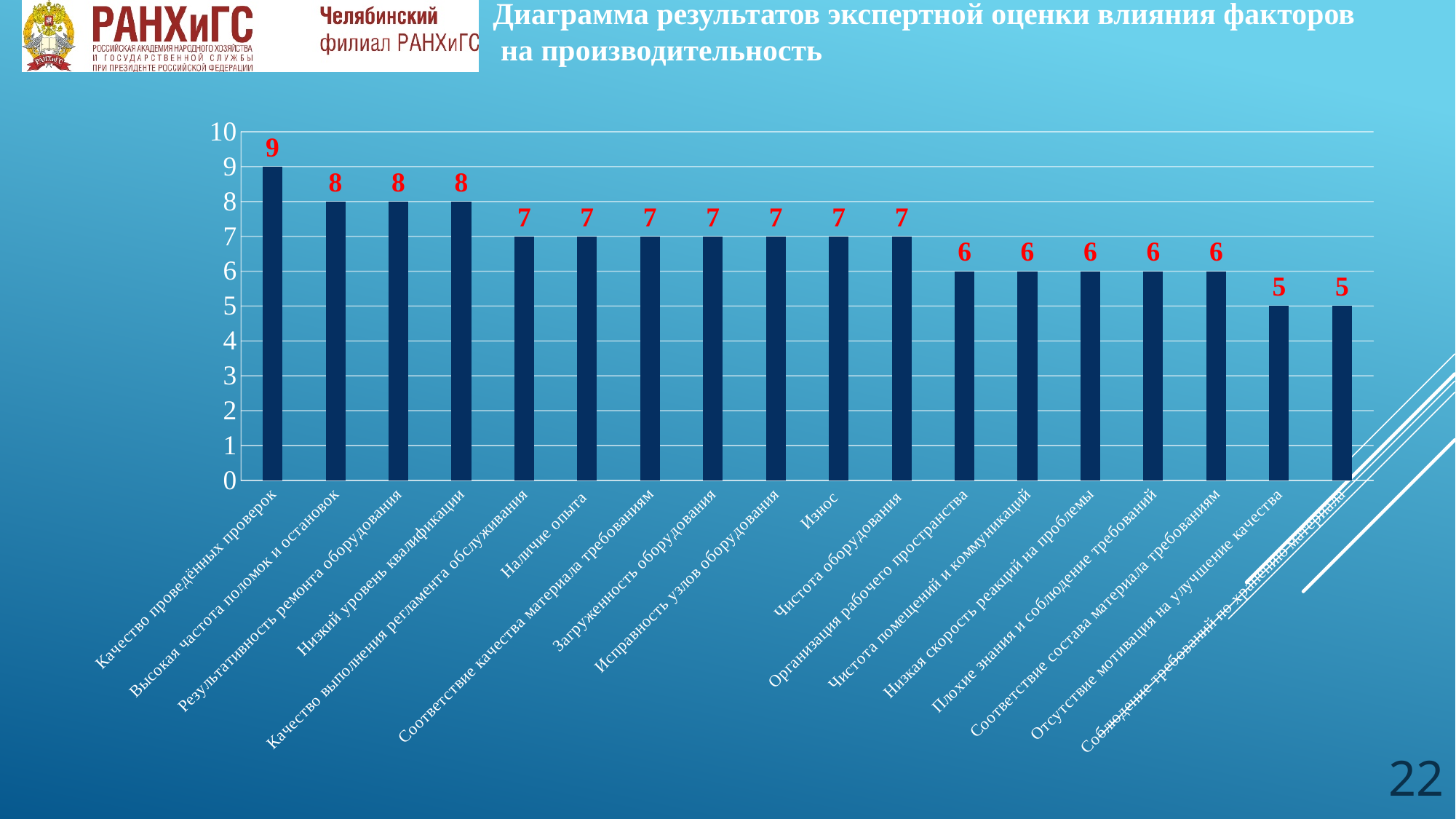
Which category has the highest value? Качество проведённых проверок How many bars are plotted in the chart? 18 Which is larger: the value for "Высокая частота поломок и остановок" or the value for "Чистота оборудования"? Высокая частота поломок и остановок What is the value for "Износ"? 7 What is the value for "Качество проведённых проверок"? 9 What is the value for "Низкий уровень квалификации"? 8 What is the value for "Отсутствие мотивации на улучшение качества"? 5 What type of chart is shown on the slide? bar chart What is the title of the chart on the slide? Диаграмма результатов экспертной оценки влияния факторов на производительность Do the values generally rise or fall from left to right along the x axis? fall What is the difference between the values for "Качество проведённых проверок" and "Наличие опыта"? 2 What is the value for "Организация рабочего пространства"? 6